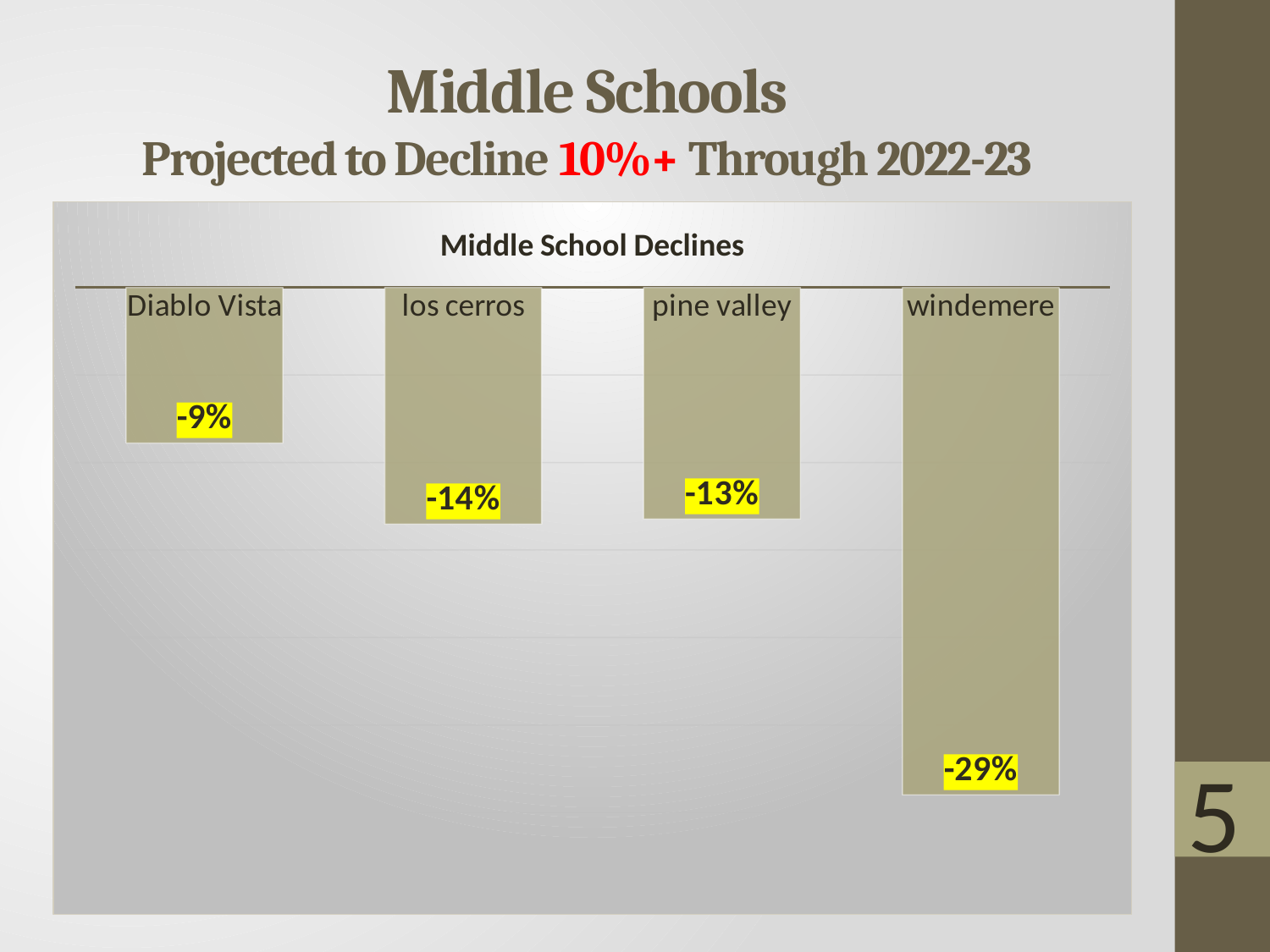
What is the difference in percentage points between the declines for windemere and Diablo Vista? 20 percentage points Which school has the smallest projected decline? Diablo Vista What is the projected decline for los cerros? -14% How many schools are shown in the chart? 4 What is the projected decline for Diablo Vista? -9% Which school has the largest projected decline? windemere What is the projected decline for windemere? -29% What type of chart is shown on the slide? Bar chart What is the projected decline for pine valley? -13% Which school has a larger projected decline, los cerros or pine valley? los cerros What is the title of the chart? Middle School Declines What is the difference in percentage points between the declines for los cerros and pine valley? 1 percentage point